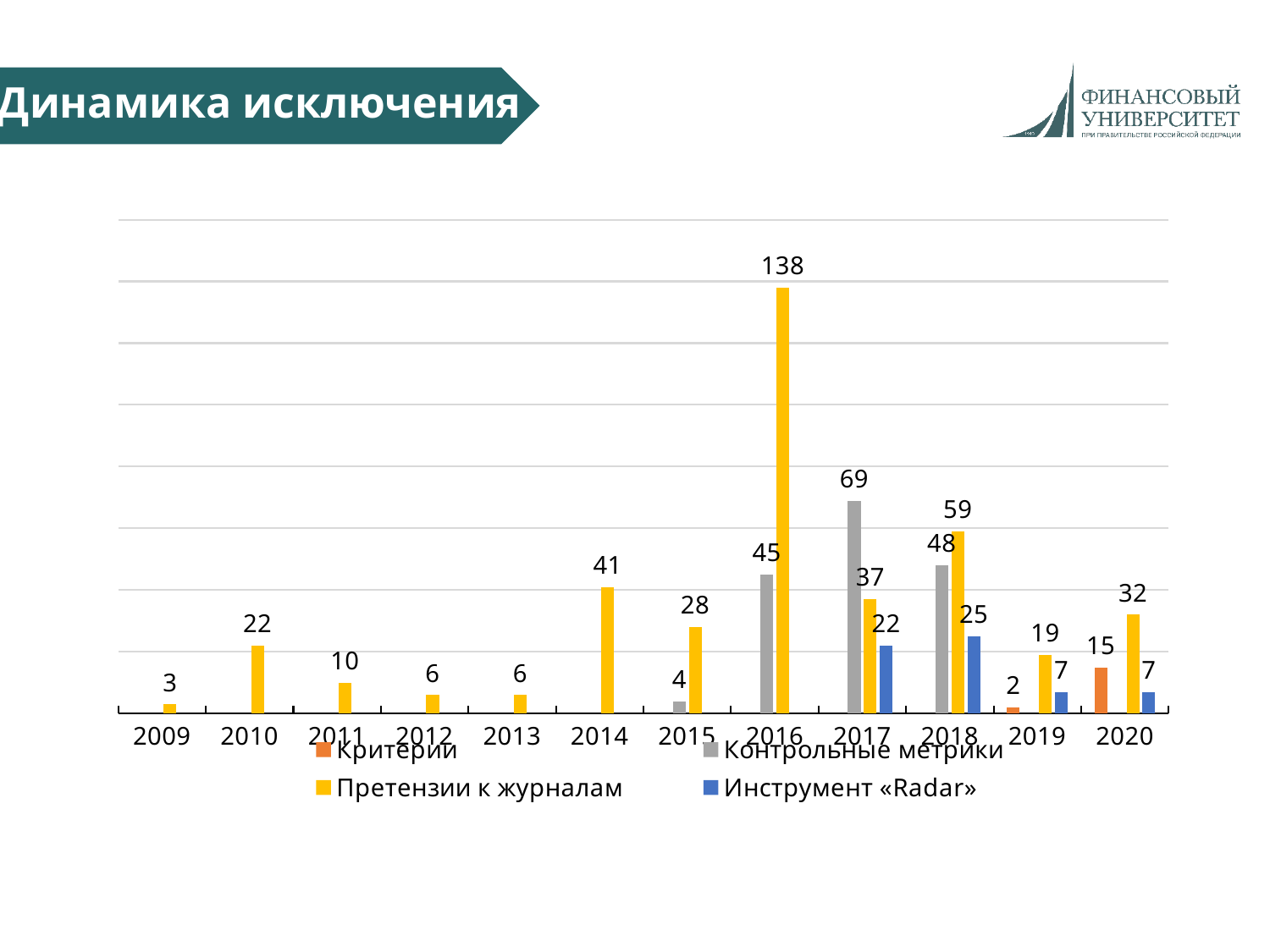
How many series does the legend list? 4 What is the value of Критерии in 2020? 15 What is the value of Контрольные метрики in 2017? 69 In which year is Претензии к журналам lowest? 2009 What is the value of Инструмент «Radar» in 2018? 25 How many years are shown on the x axis? 12 What is the title of the slide containing the chart? Динамика исключения What is the difference between Претензии к журналам in 2016 and in 2017? 101 Which is larger in 2018: Контрольные метрики or Претензии к журналам? Претензии к журналам What is the value of Претензии к журналам in 2016? 138 In which year is Претензии к журналам highest? 2016 What kind of chart is shown on the slide? bar chart